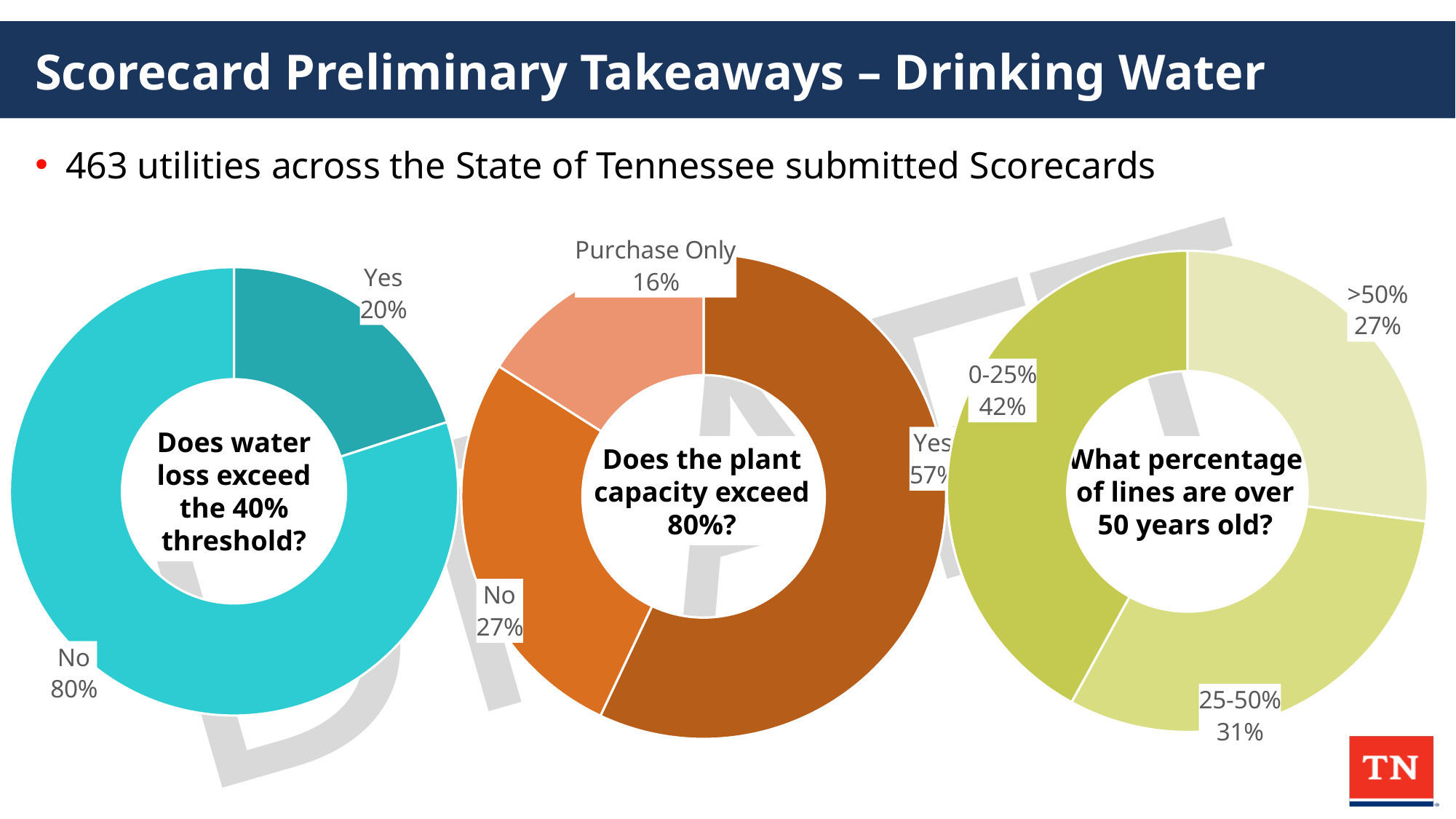
In the 'What percentage of lines are over 50 years old?' chart, which is larger: the 25-50% share or the >50% share? 25-50% In the 'What percentage of lines are over 50 years old?' chart, what share is in the 0-25% category? 42% What kind of chart is used for the three charts on the slide? Donut (pie) chart In the 'Does water loss exceed the 40% threshold?' chart, what is the difference between the No and Yes shares? 60% In the 'Does water loss exceed the 40% threshold?' chart, what share of utilities answered No? 80% In the 'What percentage of lines are over 50 years old?' chart, which category has the largest share? 0-25% In the 'Does the plant capacity exceed 80%?' chart, which category has the smallest share? Purchase Only In the 'Does the plant capacity exceed 80%?' chart, what share is labelled Purchase Only? 16% In the 'Does the plant capacity exceed 80%?' chart, what share answered Yes? 57% In the 'What percentage of lines are over 50 years old?' chart, what share is in the 25-50% category? 31% In the 'Does water loss exceed the 40% threshold?' chart, what share of utilities answered Yes? 20% In the 'Does the plant capacity exceed 80%?' chart, how many categories are shown? 3